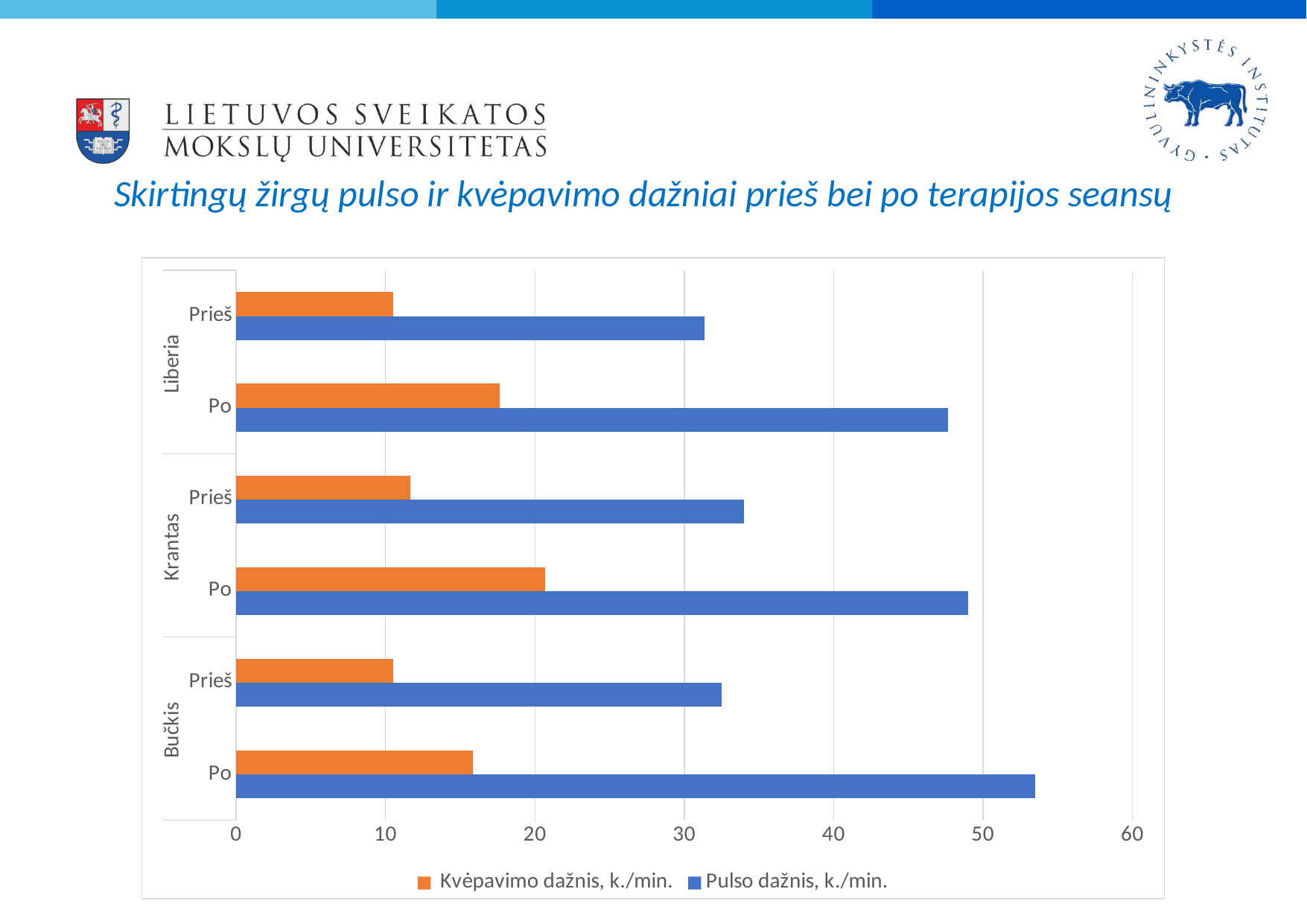
Is the Pulso dažnis value for Krantas Prieš greater or less than 30? greater What kind of chart is shown on the slide? Bar chart Which horse and condition has the highest Kvėpavimo dažnis value? Krantas, Po Which horse and condition has the highest Pulso dažnis value? Bučkis, Po Is the Pulso dažnis value for Bučkis Po greater or less than 50? greater Which is larger: the Pulso dažnis value for Bučkis Po or for Krantas Po? Bučkis Po How many series does the chart legend list? 2 Is the Pulso dažnis value for Liberia Po greater or less than 50? less What are the two series named in the legend? Kvėpavimo dažnis, k./min. and Pulso dažnis, k./min. For each horse, is the Pulso dažnis value higher before (Prieš) or after (Po) the therapy session? After (Po) How many horses are shown on the chart's vertical axis? 3